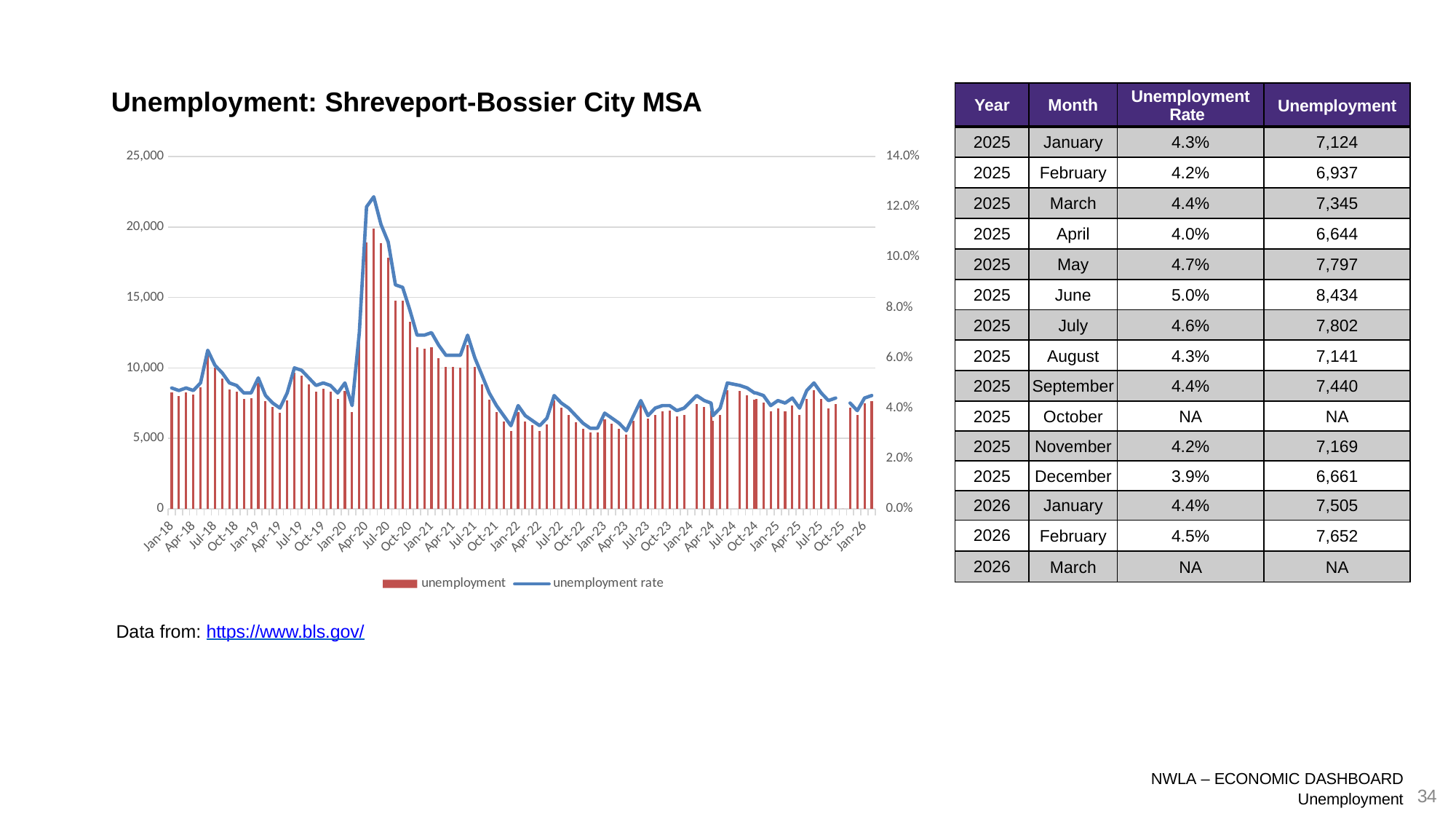
What is the difference in unemployment between June 2025 and May 2025? 637 What is the title of the chart? Unemployment: Shreveport-Bossier City MSA What was the unemployment rate for June 2025? 5.0% Is the unemployment value for Jan-18 greater or less than 10,000? less What kind of chart is shown on the slide? A combined bar and line chart How many series does the chart legend list? 2 Which month has the lowest unemployment rate among those listed in the table? December 2025 What are the two series named in the chart legend? unemployment and unemployment rate What was the unemployment count for June 2025? 8,434 Is the unemployment rate for Apr-20 greater or less than 10.0%? greater Between Apr-20 and Jan-21, does the unemployment rate rise or fall? fall In which year does the unemployment rate line reach its peak? 2020